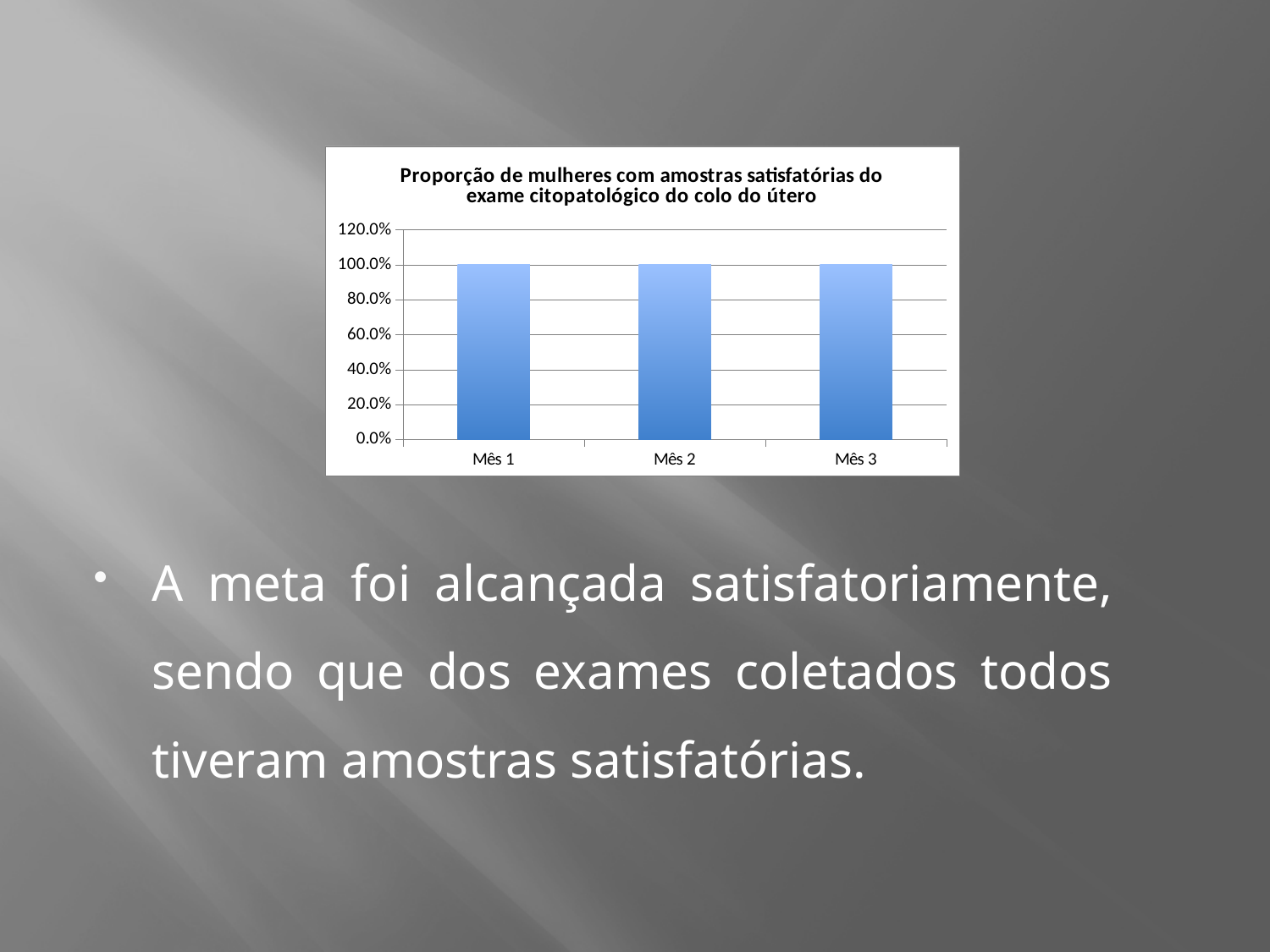
Is the value for Mês 1 greater or less than 80.0%? greater What type of chart is shown on the slide? bar chart How many categories (months) are shown on the x axis of the chart? 3 What is the value for Mês 1? 100.0% What is the title of the chart? Proporção de mulheres com amostras satisfatórias do exame citopatológico do colo do útero Do the values rise, fall, or stay the same from Mês 1 to Mês 3? stay the same What is the highest value shown on the y axis of the chart? 120.0% What is the value for Mês 2? 100.0% What is the value for Mês 3? 100.0% What is the difference between the values for Mês 1 and Mês 2? 0.0% Is the value for Mês 3 greater or less than 120.0%? less